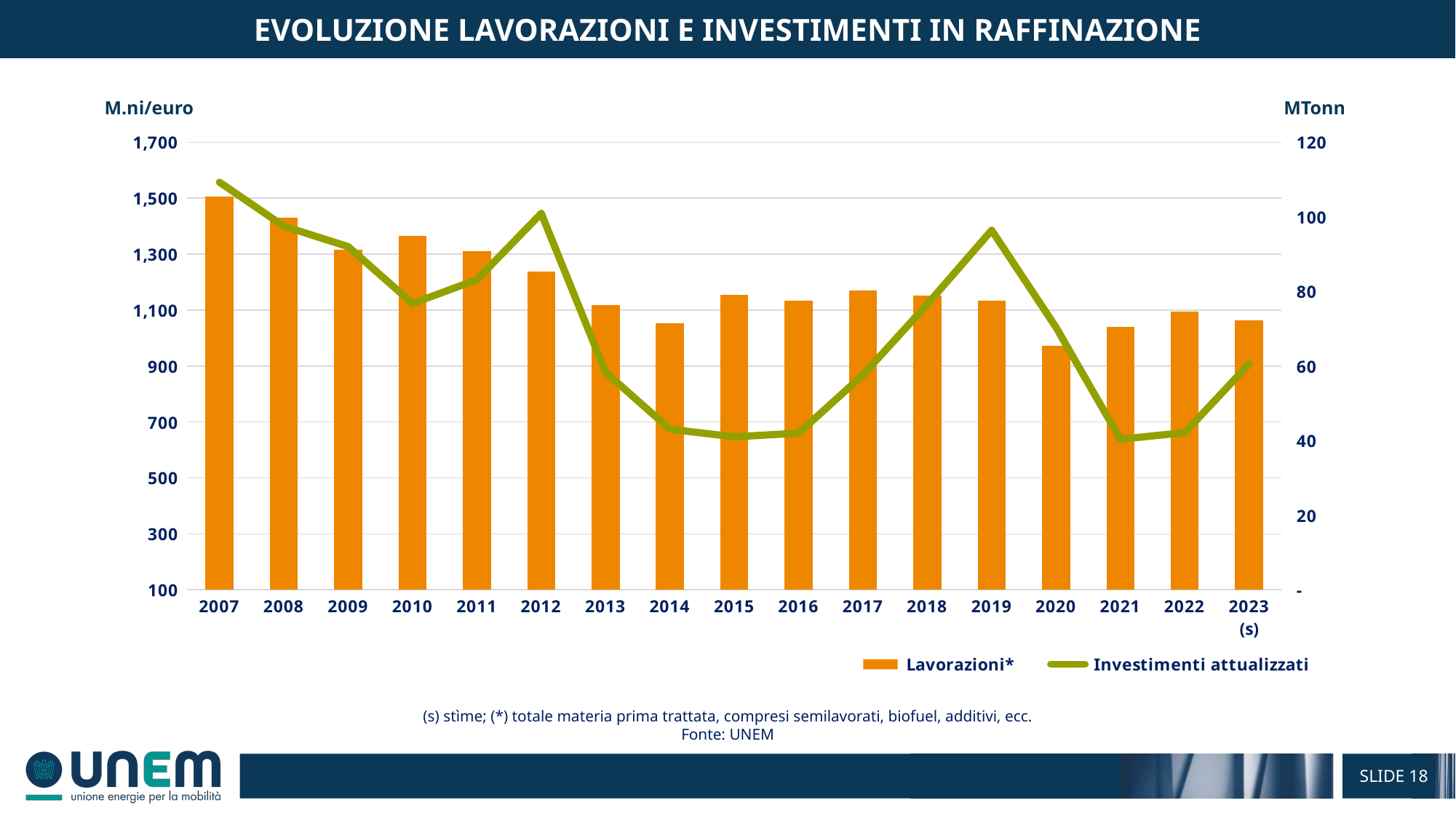
Which year has the tallest Lavorazioni* bar? 2007 Does the Investimenti attualizzati line rise or fall between 2016 and 2019? Rise What unit is shown on the right-hand axis of the chart? MTonn Does the Investimenti attualizzati line rise or fall between 2012 and 2015? Fall Read against the left axis, is the Lavorazioni* bar for 2020 greater or less than 1,100? less Which year has the shortest Lavorazioni* bar? 2020 In which year does the Investimenti attualizzati line reach its lowest point? 2021 How many series does the legend list? 2 How many years are shown along the x axis? 17 What kind of chart is shown on the slide? A combination bar and line chart Which year has the taller Lavorazioni* bar, 2012 or 2013? 2012 In which year does the Investimenti attualizzati line reach its highest point? 2007